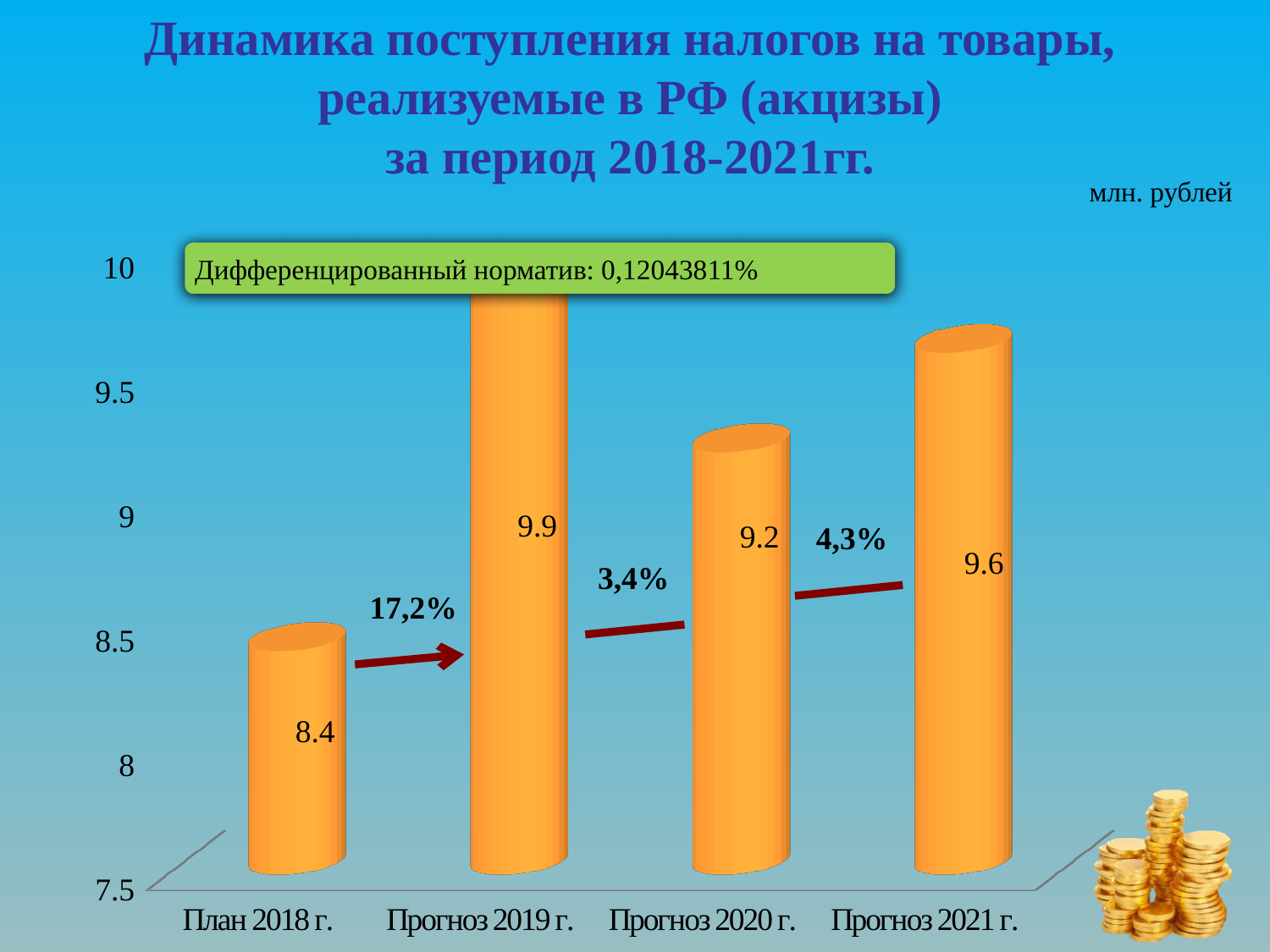
What is the value for Прогноз 2019 г.? 9.9 What percentage change is labelled between План 2018 г. and Прогноз 2019 г.? 17,2% Which is larger, the value for Прогноз 2020 г. or Прогноз 2021 г.? Прогноз 2021 г. What is the value for Прогноз 2021 г.? 9.6 What is the value for План 2018 г.? 8.4 What kind of chart is shown on the slide? Bar chart Which category has the highest value? Прогноз 2019 г. What is the difference between the values for Прогноз 2021 г. and Прогноз 2020 г.? 0.4 What is the value for Прогноз 2020 г.? 9.2 What is the difference between the values for Прогноз 2019 г. and План 2018 г.? 1.5 Which category has the lowest value? План 2018 г. How many categories are shown on the chart? 4